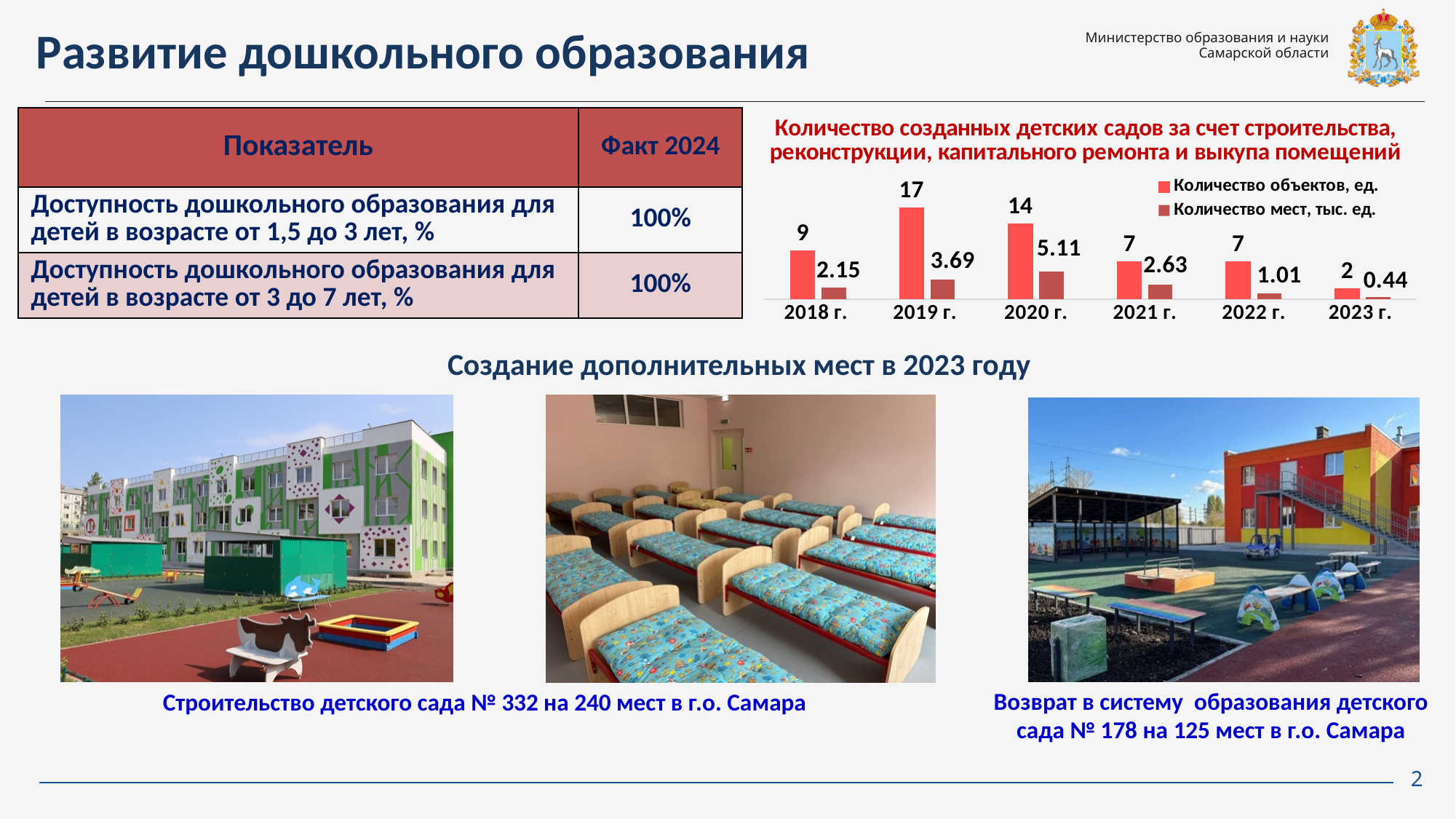
Which year has a larger value of "Количество мест, тыс. ед.": 2018 г. or 2021 г.? 2021 г. What type of chart is shown on the slide? bar chart How many years are shown on the x axis of the chart? 6 In which year is "Количество объектов, ед." the highest? 2019 г. How many series does the chart legend list? 2 Does "Количество объектов, ед." rise or fall from 2020 г. to 2023 г.? fall What is the value of "Количество мест, тыс. ед." for 2023 г.? 0.44 What is the title of the chart? Количество созданных детских садов за счет строительства, реконструкции, капитального ремонта и выкупа помещений What is the value of "Количество мест, тыс. ед." for 2020 г.? 5.11 In which year is "Количество мест, тыс. ед." the lowest? 2023 г. What is the difference in "Количество объектов, ед." between 2019 г. and 2020 г.? 3 What is the value of "Количество объектов, ед." for 2019 г.? 17